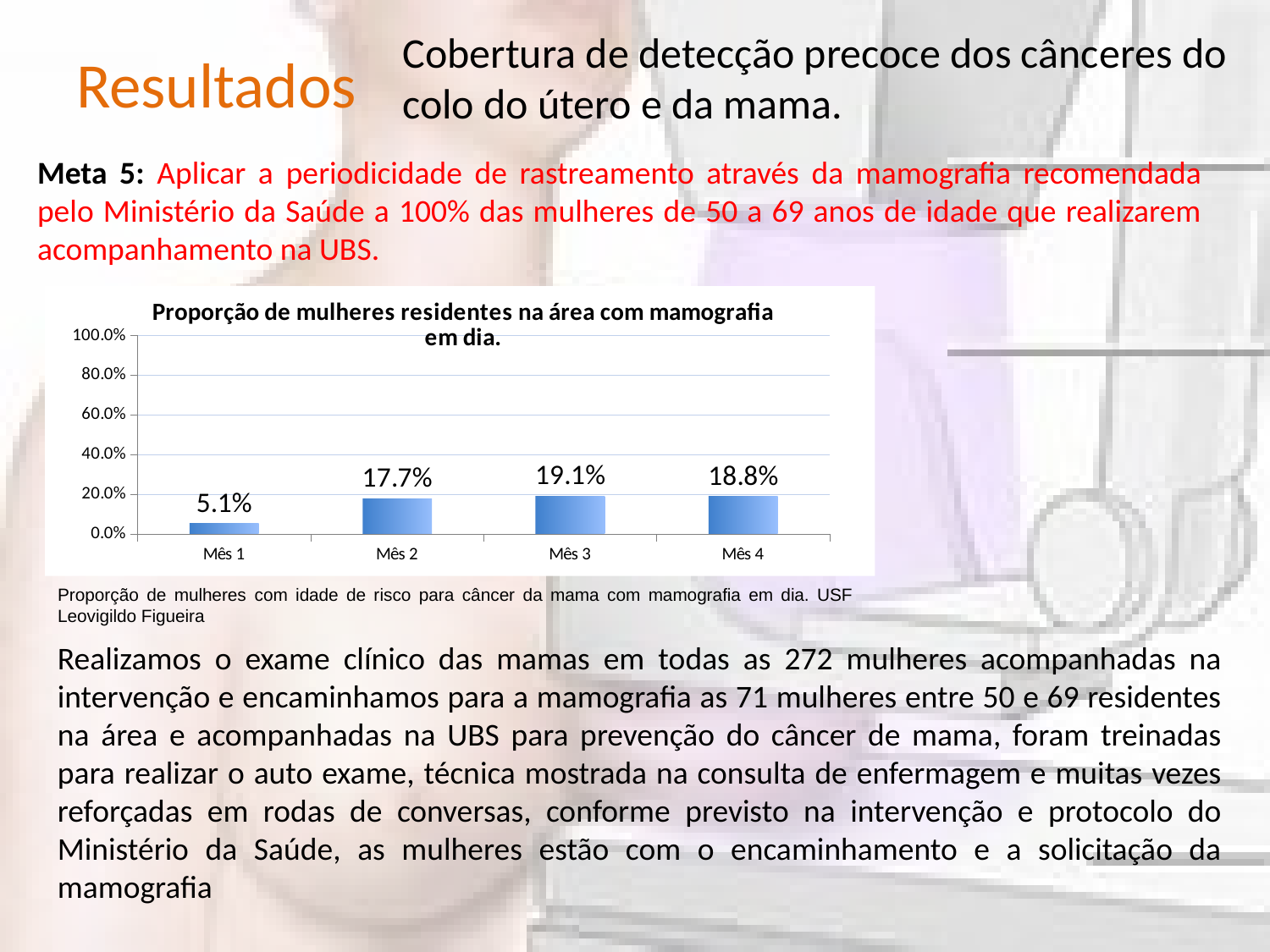
What is the value for Mês 3? 19.1% What is the value for Mês 4? 18.8% Which is larger, the value for Mês 2 or the value for Mês 4? Mês 4 What is the difference between the values for Mês 2 and Mês 1? 12.6% Is the value for Mês 3 greater or less than 20.0%? less Which month has the highest value? Mês 3 What is the difference between the values for Mês 3 and Mês 4? 0.3% What is the title of the chart? Proporção de mulheres residentes na área com mamografia em dia. What is the value for Mês 1? 5.1% How many months are shown on the x axis? 4 What kind of chart is shown on the slide? bar chart Which month has the lowest value? Mês 1